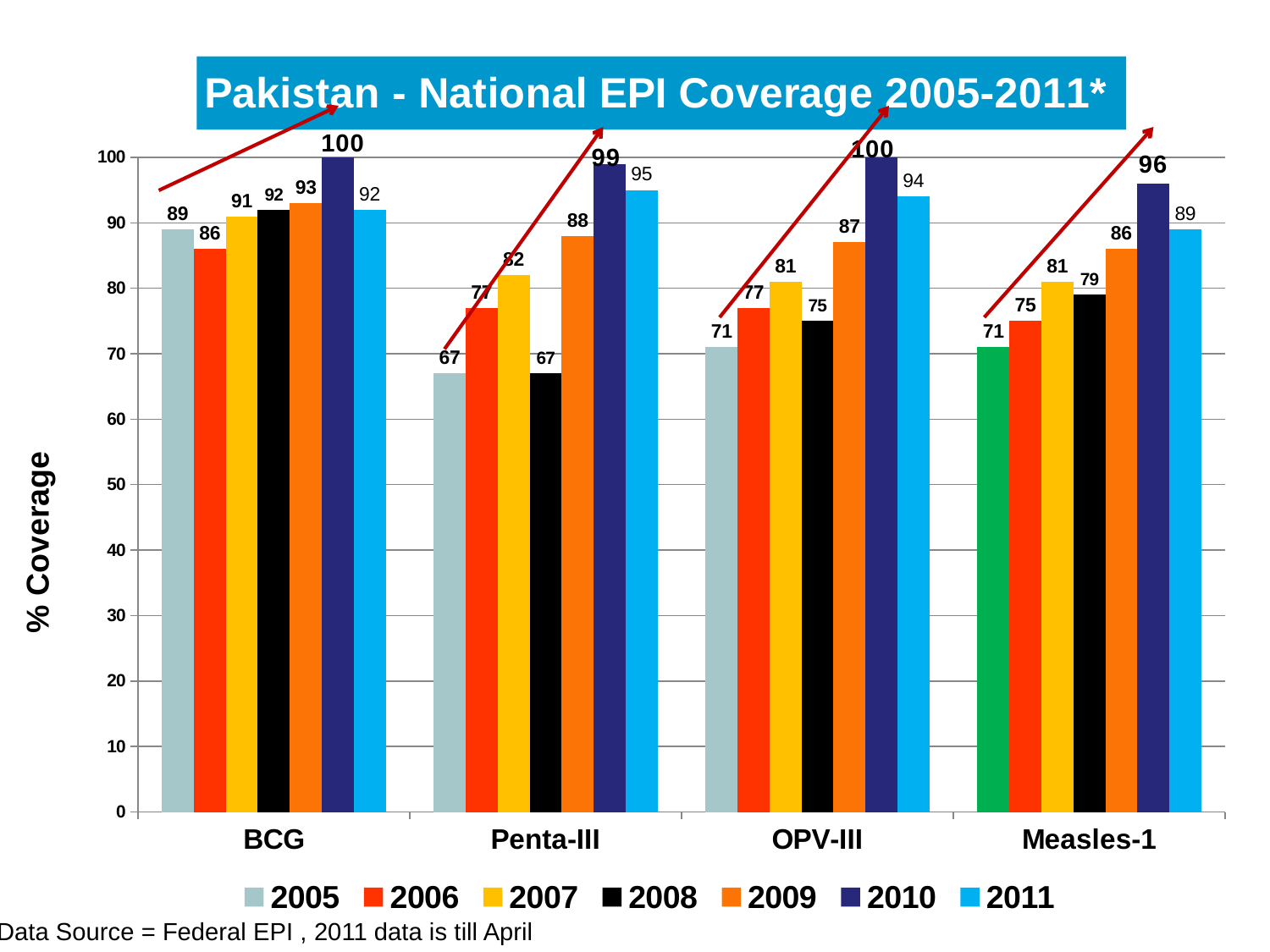
Which is larger, the 2008 coverage for BCG or for Penta-III? BCG What is the difference between the Measles-1 coverage in 2010 and in 2005? 25 For BCG, which year has the highest coverage? 2010 What is the Penta-III coverage value for 2009? 88 Is the Penta-III coverage value for 2005 greater or less than 70? less How many vaccine categories are shown on the x axis? 4 What is the BCG coverage value for 2010? 100 What kind of chart is shown on the slide? bar chart For Measles-1, which year has the lowest coverage? 2005 How many series does the legend list? 7 What is the OPV-III coverage value for 2011? 94 What is the Measles-1 coverage value for 2008? 79